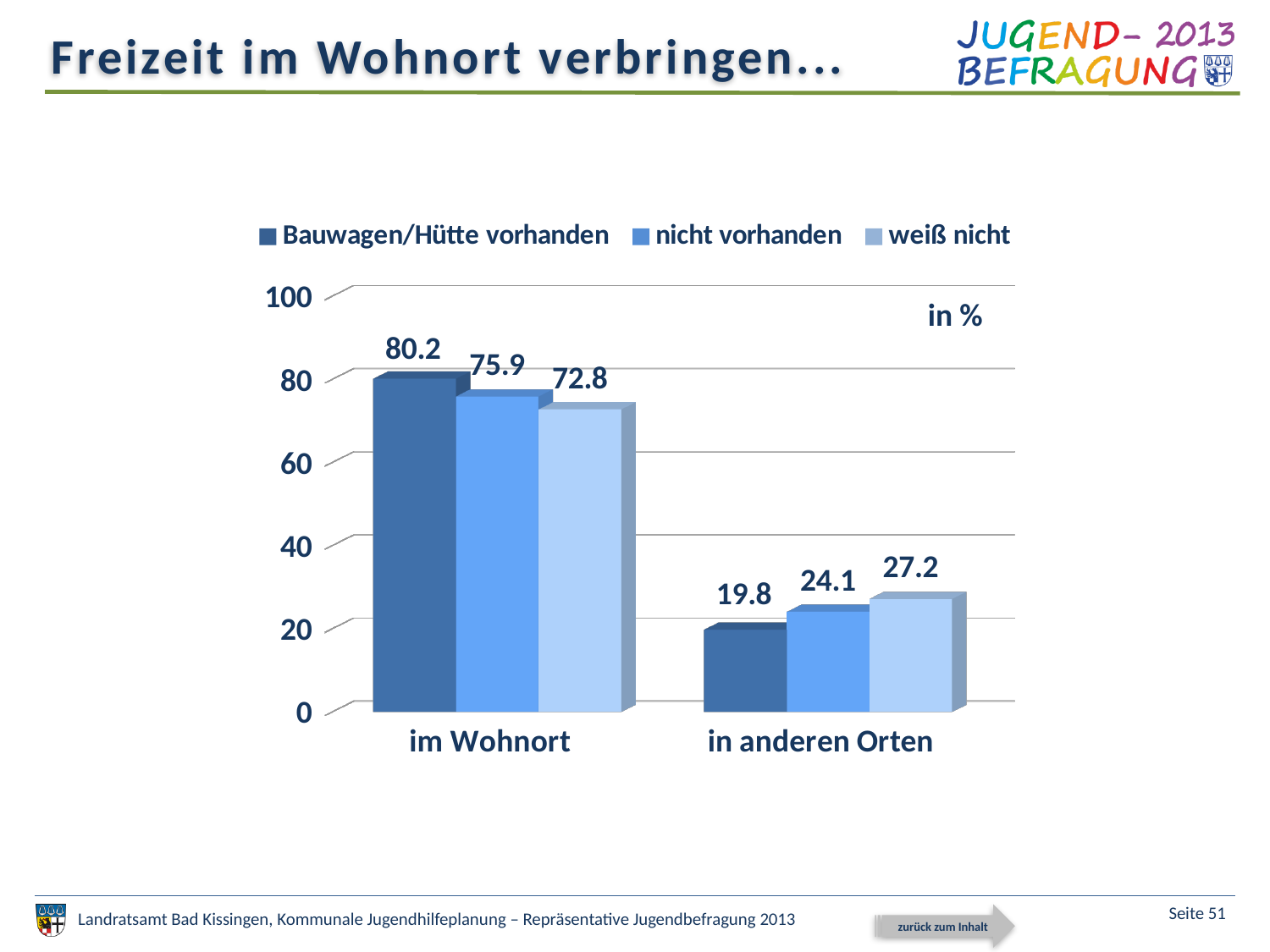
What is the value for "nicht vorhanden" in the "im Wohnort" category? 75.9 Which series has the highest value in the "im Wohnort" category? Bauwagen/Hütte vorhanden What is the value for "weiß nicht" in the "in anderen Orten" category? 27.2 Is the value for "nicht vorhanden" in "in anderen Orten" greater or less than 40? less What kind of chart is shown on the slide? bar chart What is the value for "Bauwagen/Hütte vorhanden" in the "im Wohnort" category? 80.2 How many categories are shown on the x axis? 2 Which series has the lowest value in the "in anderen Orten" category? Bauwagen/Hütte vorhanden Which is larger: "weiß nicht" for "im Wohnort" or "weiß nicht" for "in anderen Orten"? im Wohnort What is the difference between "nicht vorhanden" and "weiß nicht" in the "in anderen Orten" category? 3.1 How many series does the legend list? 3 What is the difference between the "Bauwagen/Hütte vorhanden" values for "im Wohnort" and "in anderen Orten"? 60.4